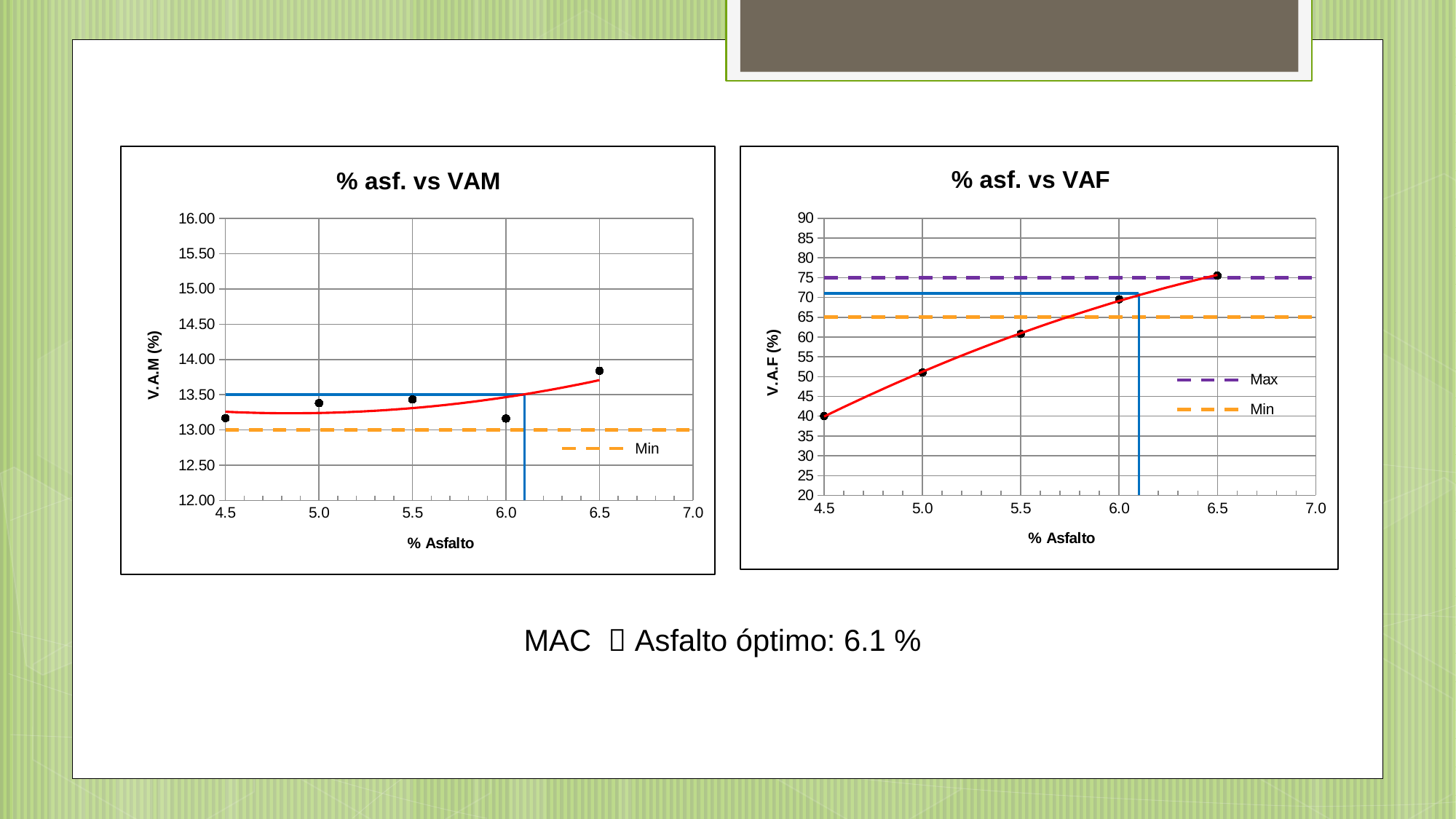
In the "% asf. vs VAM" chart, which % Asfalto value has the highest V.A.M? 6.5 How many entries does the legend of the "% asf. vs VAF" chart list? 2 What kind of chart is "% asf. vs VAM"? scatter chart In the "% asf. vs VAF" chart, is the V.A.F value at 5.5 % Asfalto greater or less than 65? less In the "% asf. vs VAF" chart, do the V.A.F values rise or fall as % Asfalto increases? rise In the "% asf. vs VAF" chart, which % Asfalto value has the lowest V.A.F? 4.5 In the "% asf. vs VAF" chart, is the V.A.F value at 6.5 % Asfalto greater or less than 70? greater How many data points are plotted in the "% asf. vs VAM" chart? 5 How many data points are plotted in the "% asf. vs VAF" chart? 5 In the "% asf. vs VAF" chart, which % Asfalto value has the highest V.A.F? 6.5 In the "% asf. vs VAM" chart, is the V.A.M value at 6.5 % Asfalto greater or less than 13.50? greater What is the y-axis label of the "% asf. vs VAM" chart? V.A.M (%)